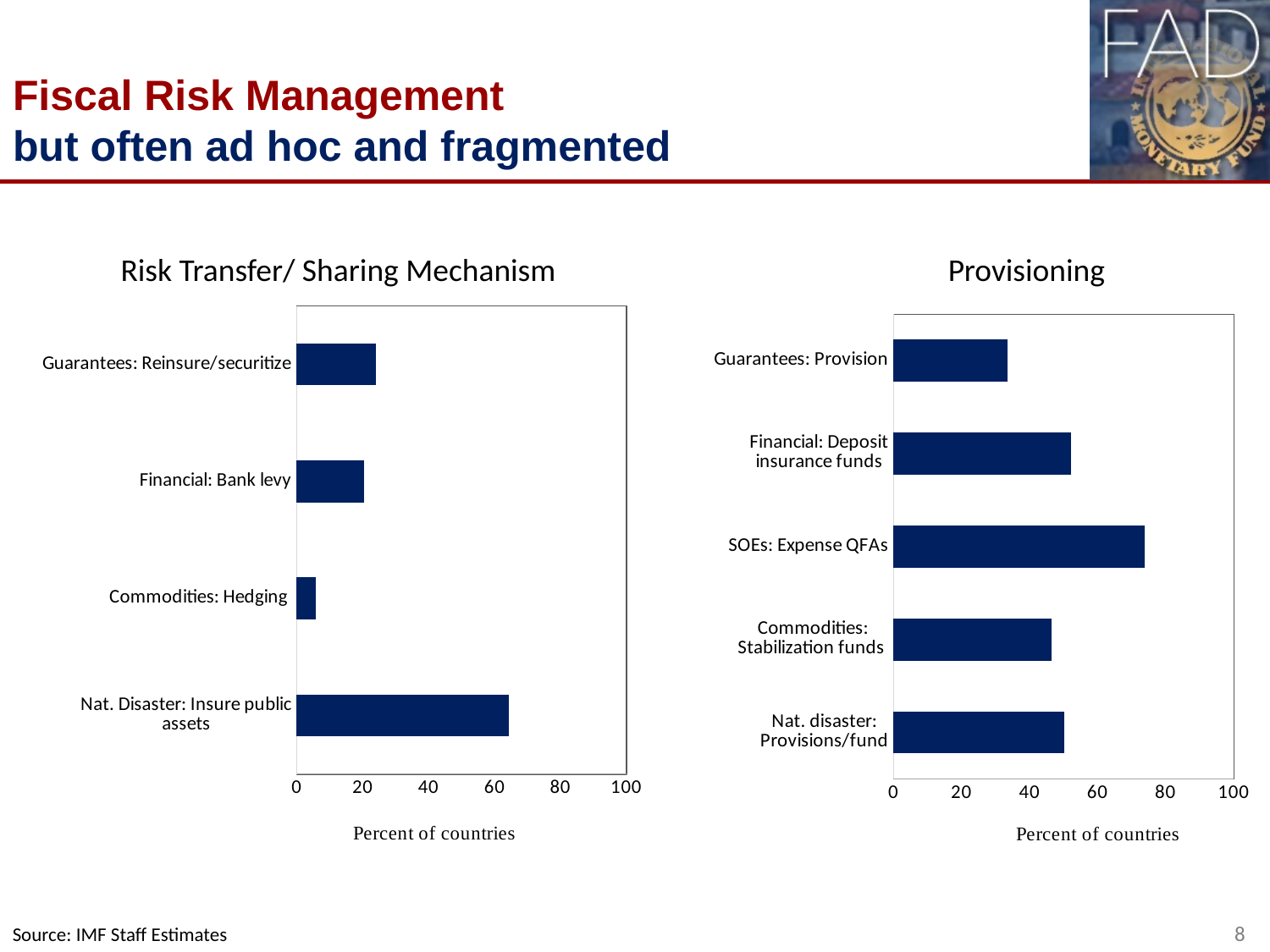
In the 'Provisioning' chart, which category has the lowest value? Guarantees: Provision How many categories are shown in the 'Provisioning' chart? 5 What kind of chart is the 'Risk Transfer/ Sharing Mechanism' chart? Bar chart What is the x-axis label of the 'Provisioning' chart? Percent of countries In the 'Risk Transfer/ Sharing Mechanism' chart, which category has the highest value? Nat. Disaster: Insure public assets In the 'Provisioning' chart, is the value for 'SOEs: Expense QFAs' greater or less than 60? greater In the 'Provisioning' chart, which is larger: 'Financial: Deposit insurance funds' or 'Guarantees: Provision'? Financial: Deposit insurance funds In the 'Risk Transfer/ Sharing Mechanism' chart, is the value for 'Commodities: Hedging' greater or less than 20? less How many categories are shown in the 'Risk Transfer/ Sharing Mechanism' chart? 4 In the 'Provisioning' chart, which category has the highest value? SOEs: Expense QFAs In the 'Risk Transfer/ Sharing Mechanism' chart, is the value for 'Nat. Disaster: Insure public assets' greater or less than 60? greater In the 'Risk Transfer/ Sharing Mechanism' chart, which category has the lowest value? Commodities: Hedging